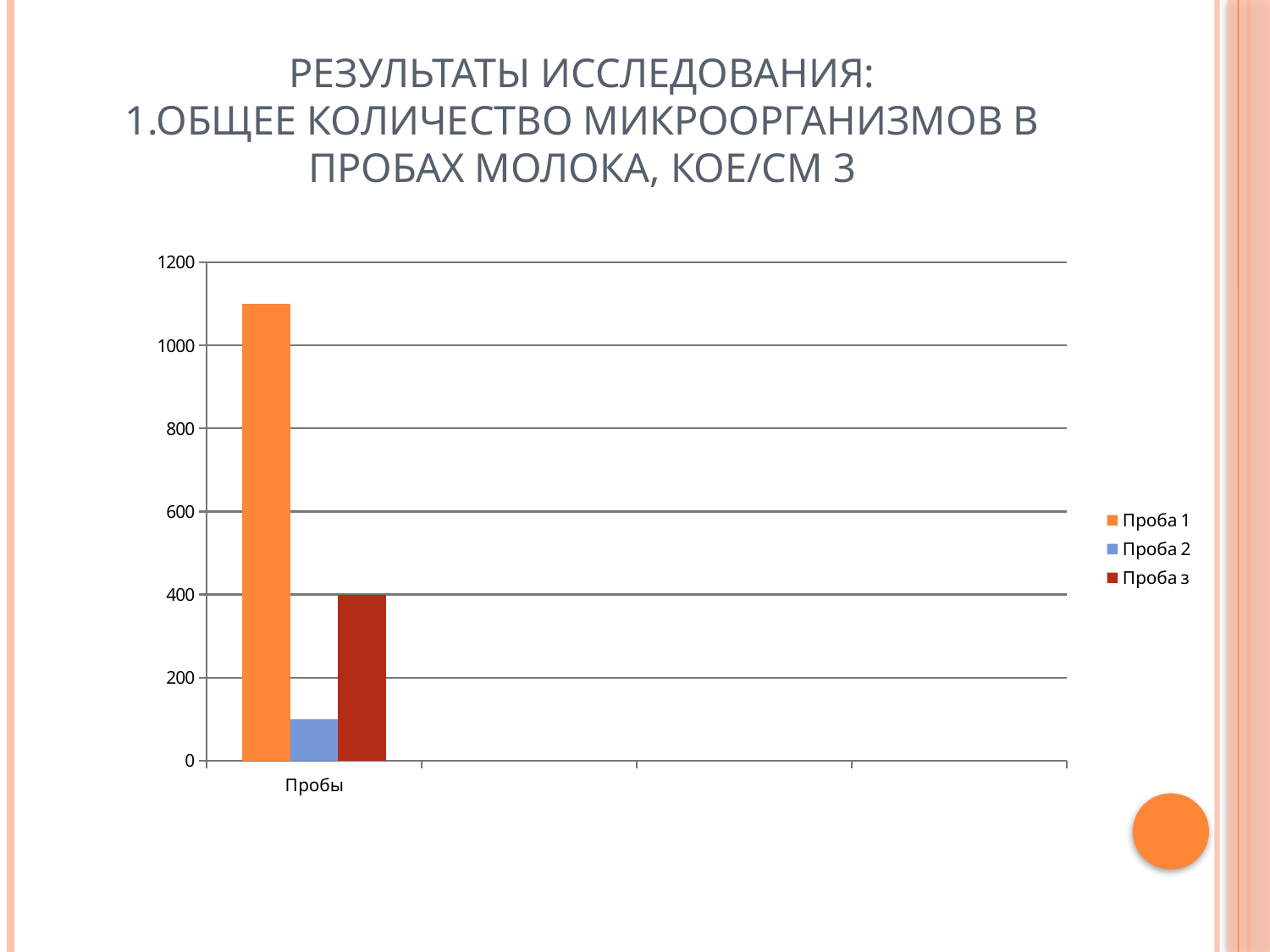
What is the label of the category on the x axis? Пробы Is the value for Проба 2 greater or less than 200? less What colour is the bar for Проба 2? blue Which is larger, the value for Проба 2 or the value for Проба з? Проба з How many categories are shown on the x axis? 1 Which series has the highest value? Проба 1 Which series has the lowest value? Проба 2 Which is larger, the value for Проба 1 or the value for Проба з? Проба 1 What is the value for Проба з? 400 Is the value for Проба 1 greater or less than 1000? greater What kind of chart is shown on the slide? bar chart How many series does the legend list? 3